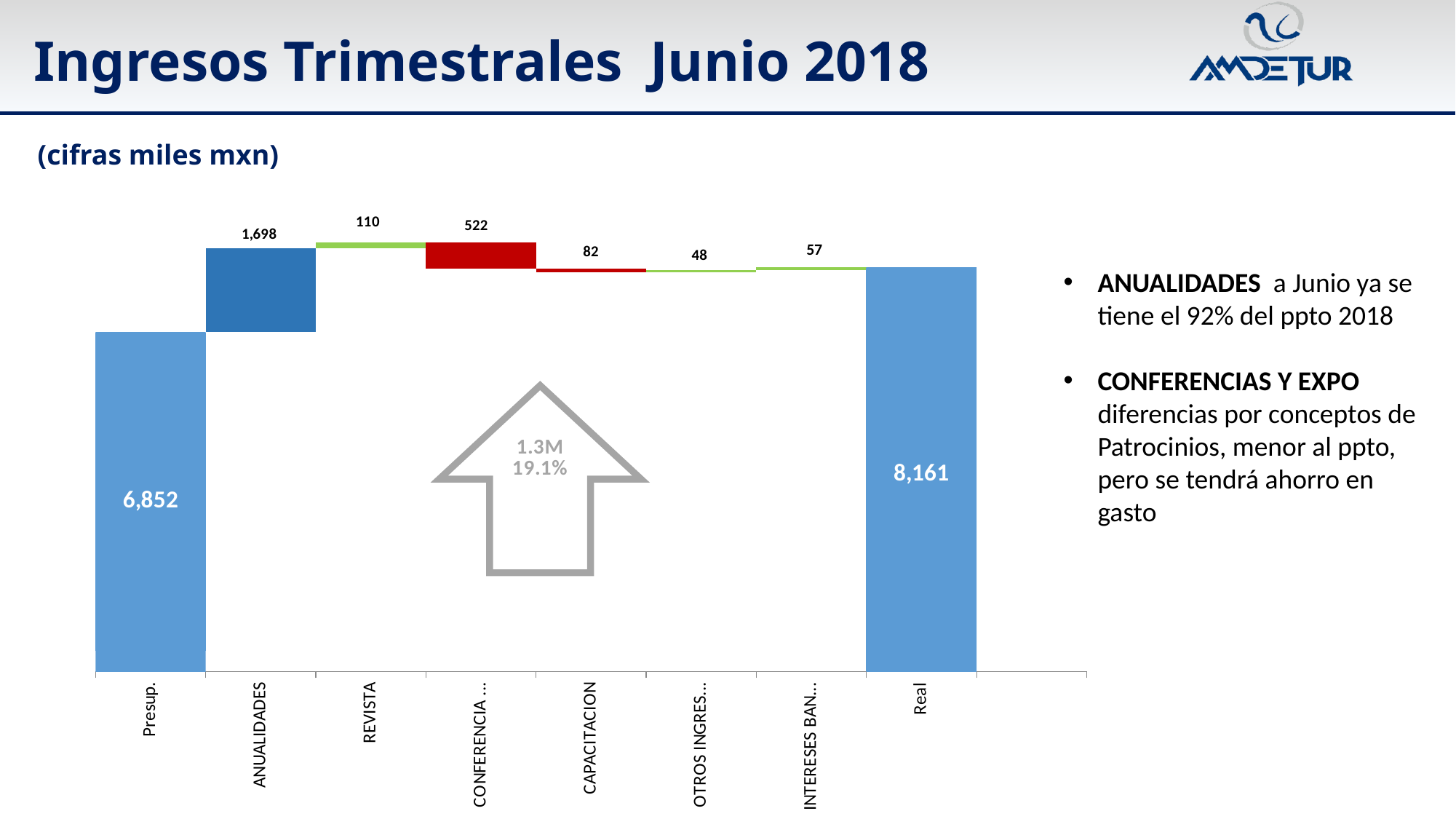
Which category has the highest value in the chart? Real What kind of chart is shown on the slide? bar chart What is the value shown for ANUALIDADES? 1,698 What is the value shown for CAPACITACION? 82 What colour is the CAPACITACION bar? red What is the value shown for Real? 8,161 What is the value shown for REVISTA? 110 Which is larger, the value for CAPACITACION or the value for INTERESES BAN...? CAPACITACION What is the difference between the ANUALIDADES value and the REVISTA value? 1,588 How many categories are shown on the x axis of the chart? 8 What is the difference between the Real value and the Presup. value? 1,309 What is the value shown for Presup.? 6,852